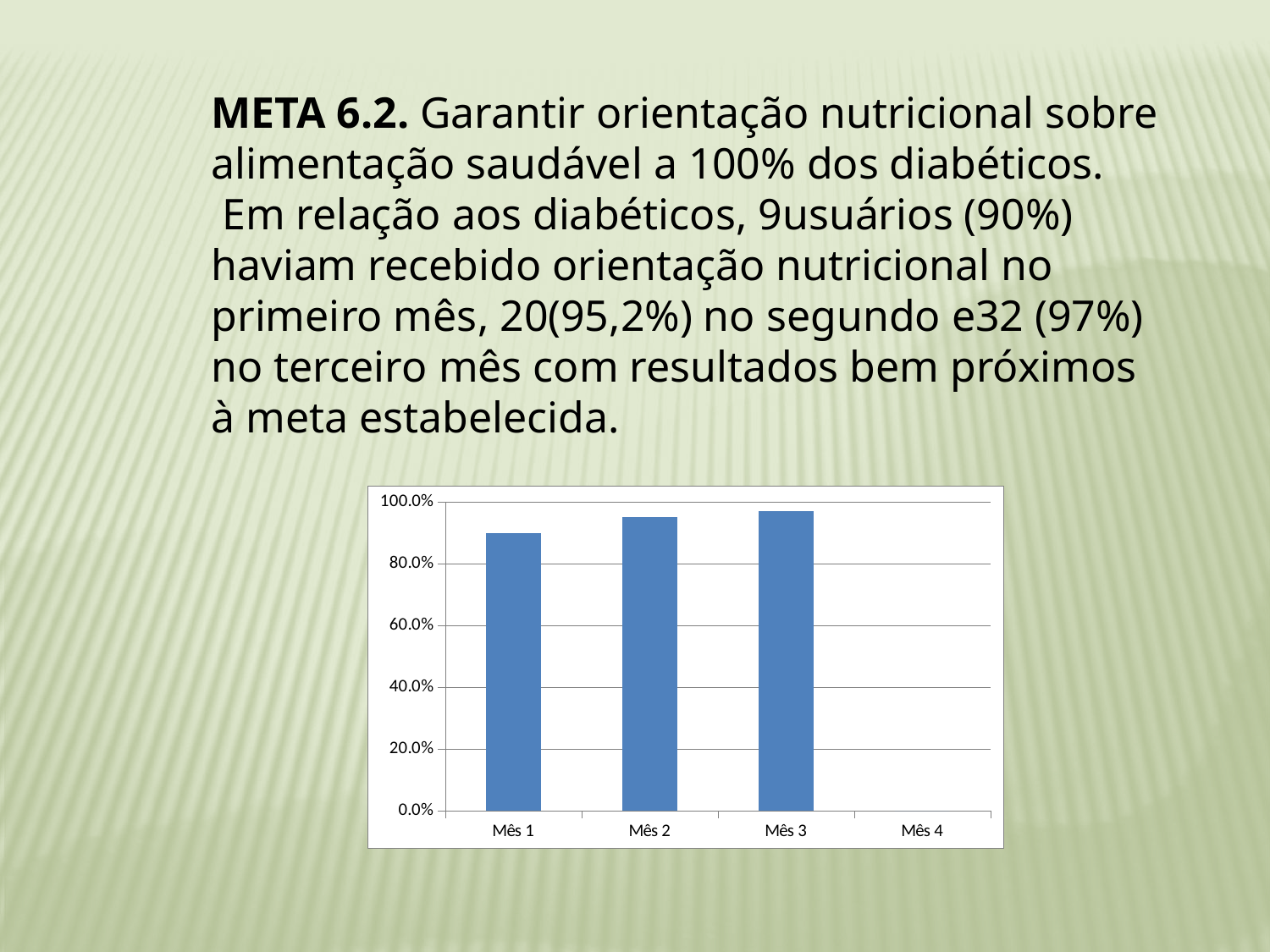
Is the value for Mês 3 greater or less than 80.0%? greater According to the slide text, what percentage of diabetics had received nutritional guidance in the first month (Mês 1)? 90% Is the value for Mês 1 greater or less than 80.0%? greater Which is larger, the value for Mês 1 or the value for Mês 2? Mês 2 Which is larger, the value for Mês 1 or the value for Mês 3? Mês 3 How many categories are shown on the x axis of the chart? 4 Is the value for Mês 2 greater or less than 100.0%? less Do the bar values rise or fall from Mês 1 to Mês 3? rise What kind of chart is shown on the slide? bar chart What is the highest tick value shown on the y axis of the chart? 100.0% Which category on the x axis has no bar plotted? Mês 4